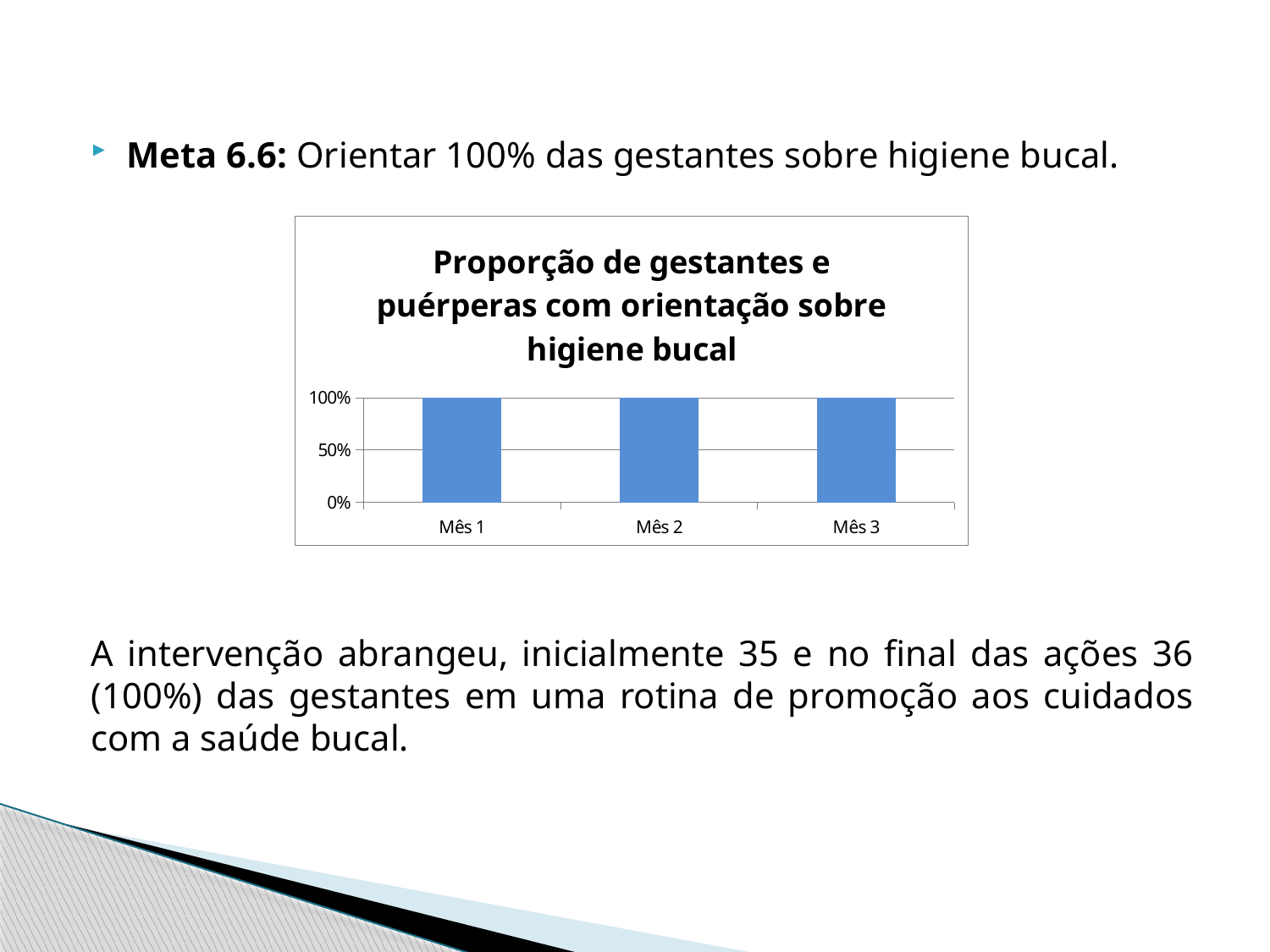
Is the value for Mês 2 greater or less than 50%? greater What is the difference between the values for Mês 1 and Mês 3? 0% Is the value for Mês 3 greater or less than 50%? greater What kind of chart is shown on the slide? bar chart What is the value for Mês 3 in the chart? 100% What is the highest value shown on the chart's vertical axis? 100% Do the values rise, fall, or stay the same from Mês 1 to Mês 3? stay the same What is the title of the chart? Proporção de gestantes e puérperas com orientação sobre higiene bucal How many categories are plotted on the x axis of the chart? 3 What is the value for Mês 2 in the chart? 100% What is the value for Mês 1 in the chart? 100%